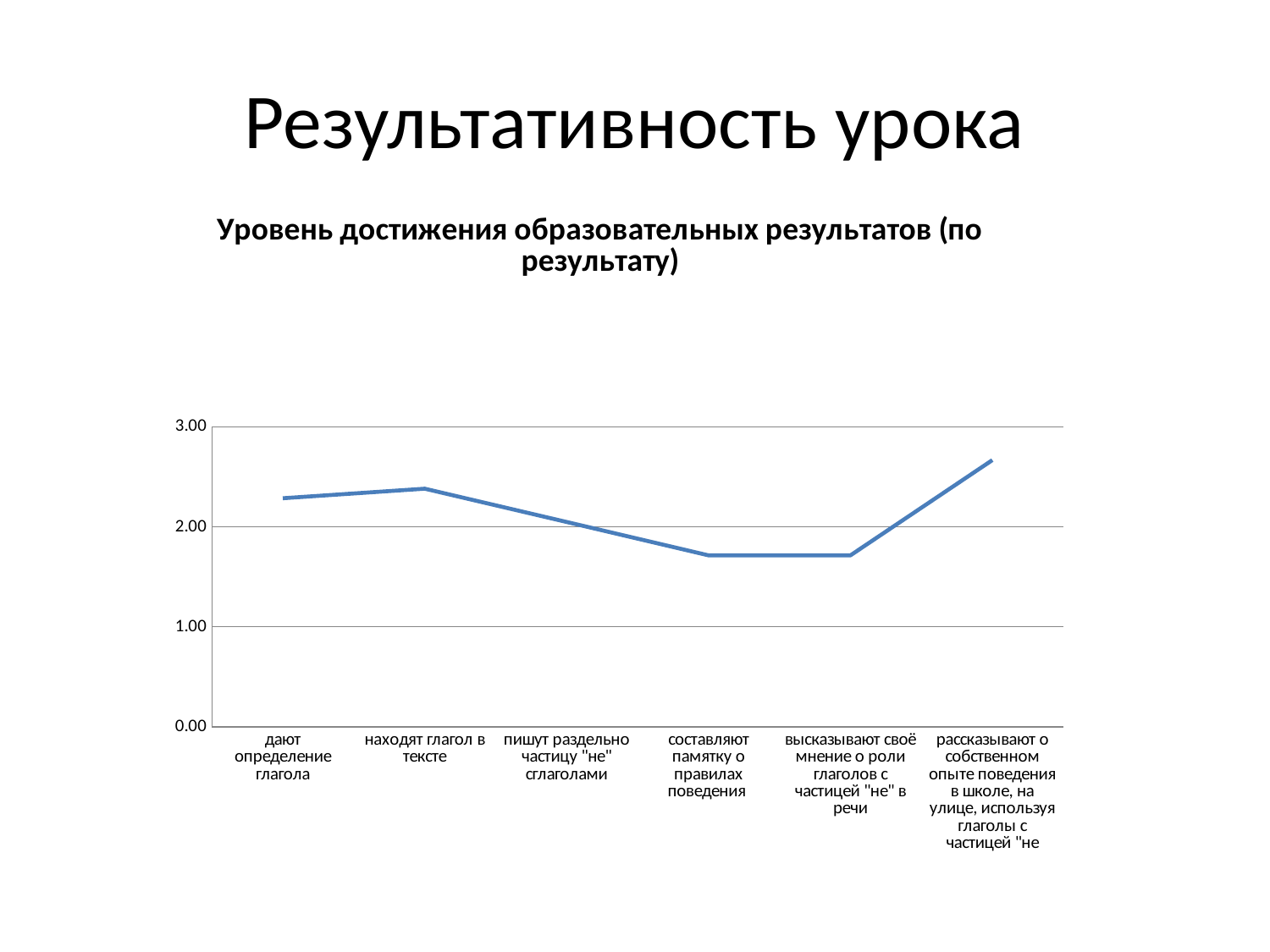
How many lines (series) are plotted on the chart? 1 Does the line rise or fall between the fifth and the sixth category on the x axis? rise Does the line rise or fall between "находят глагол в тексте" and "составляют памятку о правилах поведения"? fall How many categories are plotted along the x axis of the chart? 6 Is the value for "составляют памятку о правилах поведения" greater or less than 2.00? less Is the value for "высказывают своё мнение о роли глаголов с частицей "не" в речи" greater or less than 2.00? less Which category has the highest value on the chart? рассказывают о собственном опыте поведения в школе, на улице, используя глаголы с частицей "не Which is larger: the value for "находят глагол в тексте" or the value for "составляют памятку о правилах поведения"? находят глагол в тексте What is the title of the chart? Уровень достижения образовательных результатов (по результату) What kind of chart is shown on the slide? line chart Is the value for "находят глагол в тексте" greater or less than 3.00? less